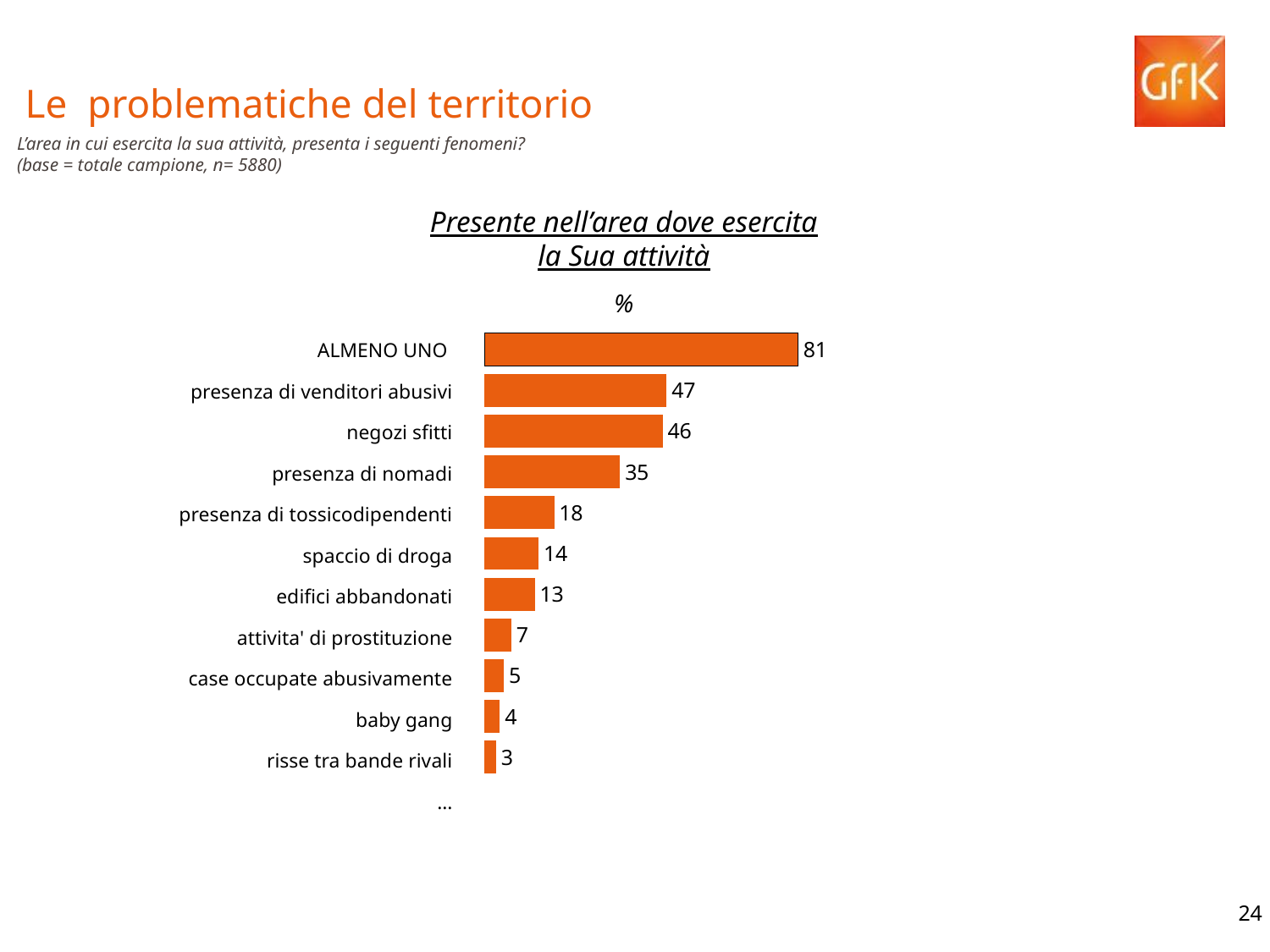
How many categories are plotted in the chart? 11 What is the value for 'spaccio di droga'? 14 What is the value for 'ALMENO UNO'? 81 What is the value for 'negozi sfitti'? 46 What is the value for 'presenza di venditori abusivi'? 47 What is the title of the chart? Presente nell'area dove esercita la Sua attività What kind of chart is shown on the slide? bar chart What is the difference between 'presenza di nomadi' and 'presenza di tossicodipendenti'? 17 Which category has the highest value? ALMENO UNO Which category has the lowest value? risse tra bande rivali Which is larger, 'edifici abbandonati' or 'attivita' di prostituzione'? edifici abbandonati What is the difference between 'ALMENO UNO' and 'presenza di venditori abusivi'? 34